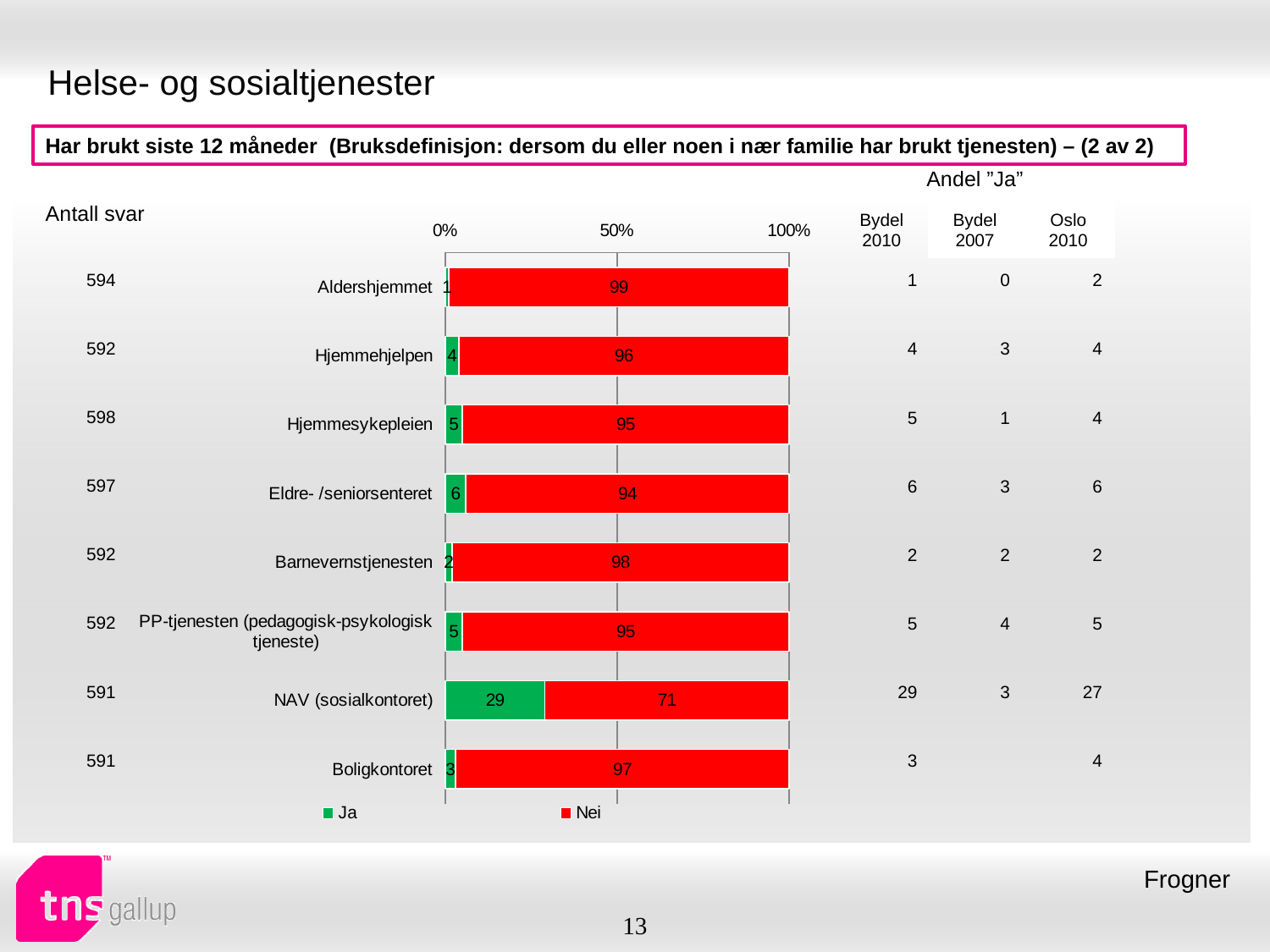
What is the difference between the 'Nei' values for Aldershjemmet and NAV (sosialkontoret)? 28 Which category has the lowest 'Ja' value? Aldershjemmet What is the 'Nei' value for NAV (sosialkontoret)? 71 Which category has the highest 'Ja' value? NAV (sosialkontoret) What kind of chart is shown on the slide? Stacked bar chart How many categories are shown in the chart? 8 What is the 'Ja' value for Eldre- /seniorsenteret? 6 Which is larger, the 'Ja' value for Hjemmehjelpen or the 'Ja' value for Eldre- /seniorsenteret? Eldre- /seniorsenteret Is the 'Nei' value for NAV (sosialkontoret) greater or less than 50%? greater How many series does the legend list? 2 What is the total of the stacked bar for Boligkontoret? 100 What is the 'Nei' value for Aldershjemmet? 99